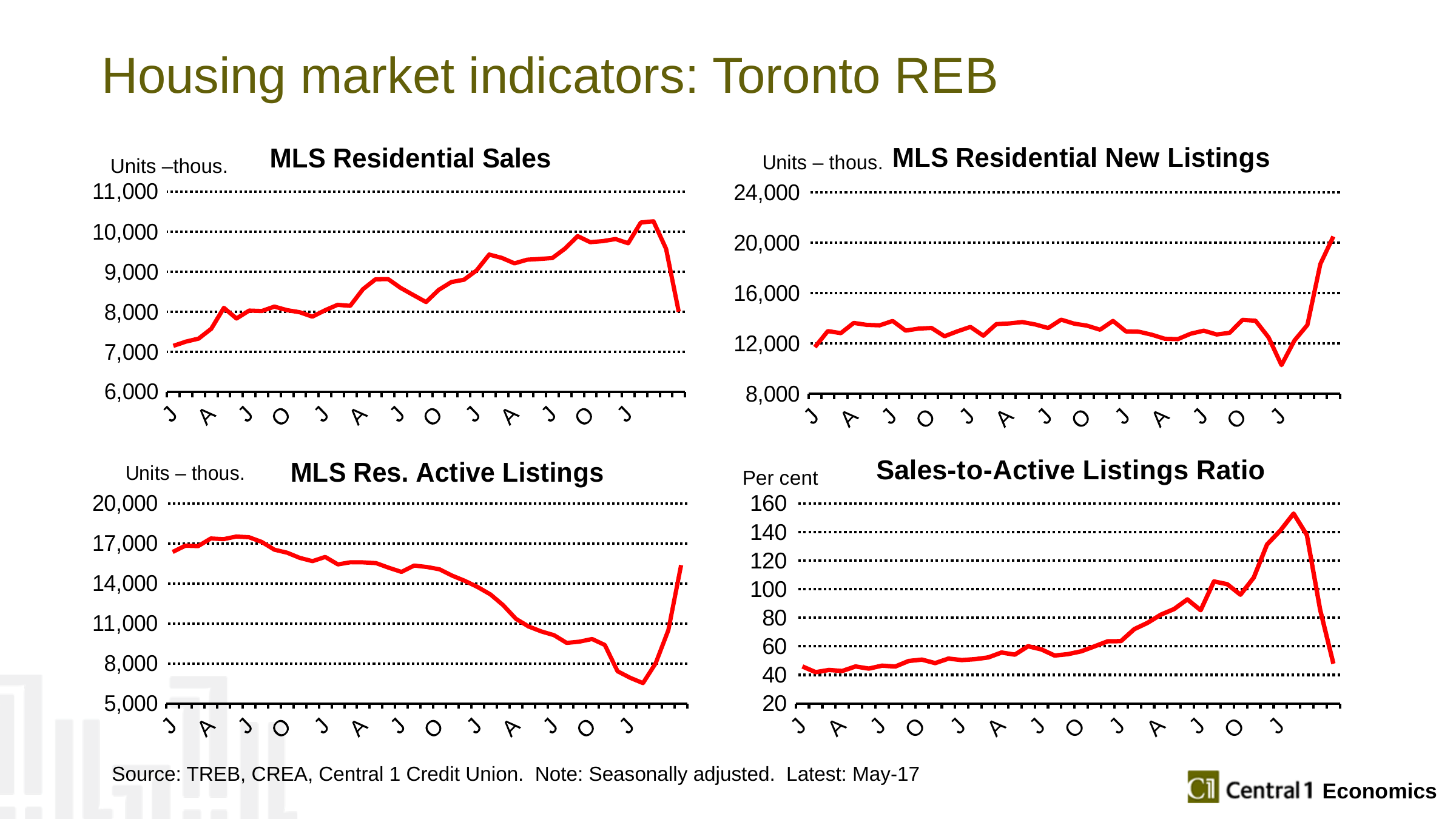
In the Sales-to-Active Listings Ratio chart, is the peak value greater or less than 140? greater In the MLS Residential New Listings chart, is the lowest point of the line greater or less than 12,000? less In the Sales-to-Active Listings Ratio chart, do the values rise or fall from the start of the period up to the peak? rise In the MLS Res. Active Listings chart, is the lowest point of the line greater or less than 8,000? less What kind of chart is the MLS Residential Sales chart? line chart What unit label is shown on the y axis of the Sales-to-Active Listings Ratio chart? Per cent In the MLS Res. Active Listings chart, do the values mainly rise or fall from the start of the period until the sharp upturn at the end? fall How many charts are shown on the slide? 4